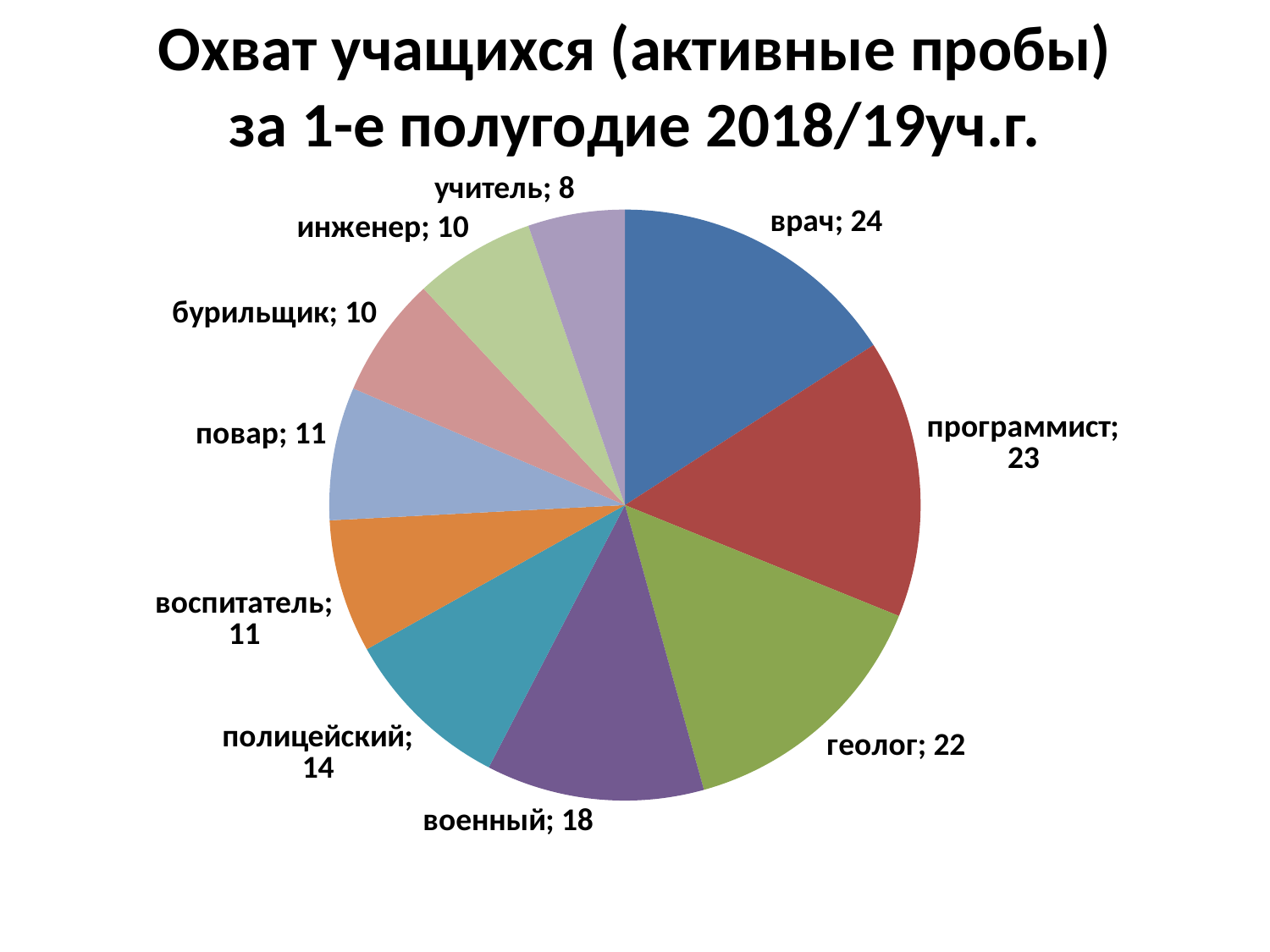
What is the difference between the values for военный and учитель? 10 What is the value for врач? 24 Which is larger, the value for полицейский or the value for повар? полицейский What is the value for программист? 23 Which category has the largest slice? врач What is the value for военный? 18 What is the value for полицейский? 14 What is the difference between the values for врач and геолог? 2 What type of chart is shown on the slide? pie chart What is the title of the chart? Охват учащихся (активные пробы) за 1-е полугодие 2018/19уч.г. Which category has the smallest slice? учитель How many categories are shown in the pie chart? 10